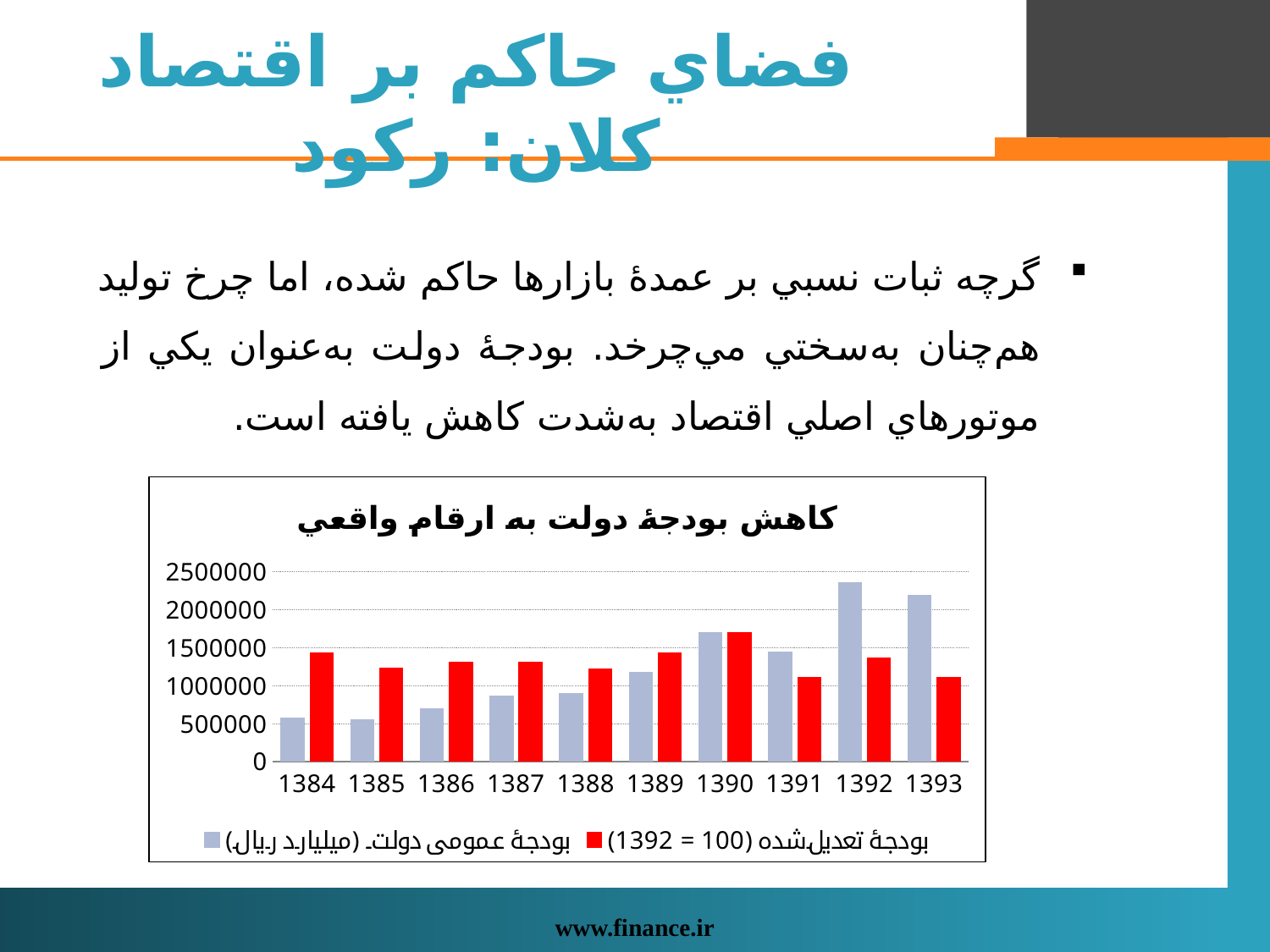
How many years are shown on the x axis of the chart? 10 What is the title of the chart? کاهش بودجهٔ دولت به ارقام واقعی For 1384, which series has the larger value: بودجهٔ تعدیل‌شده (100 = 1392) or بودجهٔ عمومی دولت (میلیارد ریال)? بودجهٔ عمومی دولت (میلیارد ریال) In which year is the value of the بودجهٔ تعدیل‌شده (100 = 1392) series highest? 1392 In which year is the value of the بودجهٔ عمومی دولت (میلیارد ریال) series highest? 1390 Which colour represents the series بودجهٔ عمومی دولت (میلیارد ریال) in the chart? red How many series does the chart's legend list? 2 Is the value of بودجهٔ تعدیل‌شده (100 = 1392) for 1392 greater or less than 2000000? greater Does the بودجهٔ تعدیل‌شده (100 = 1392) series generally rise or fall from 1384 to 1393? rise What kind of chart is shown on the slide? bar chart Is the value of بودجهٔ تعدیل‌شده (100 = 1392) for 1387 greater or less than 1000000? less Is the value of بودجهٔ عمومی دولت (میلیارد ریال) for 1390 greater or less than 1500000? greater